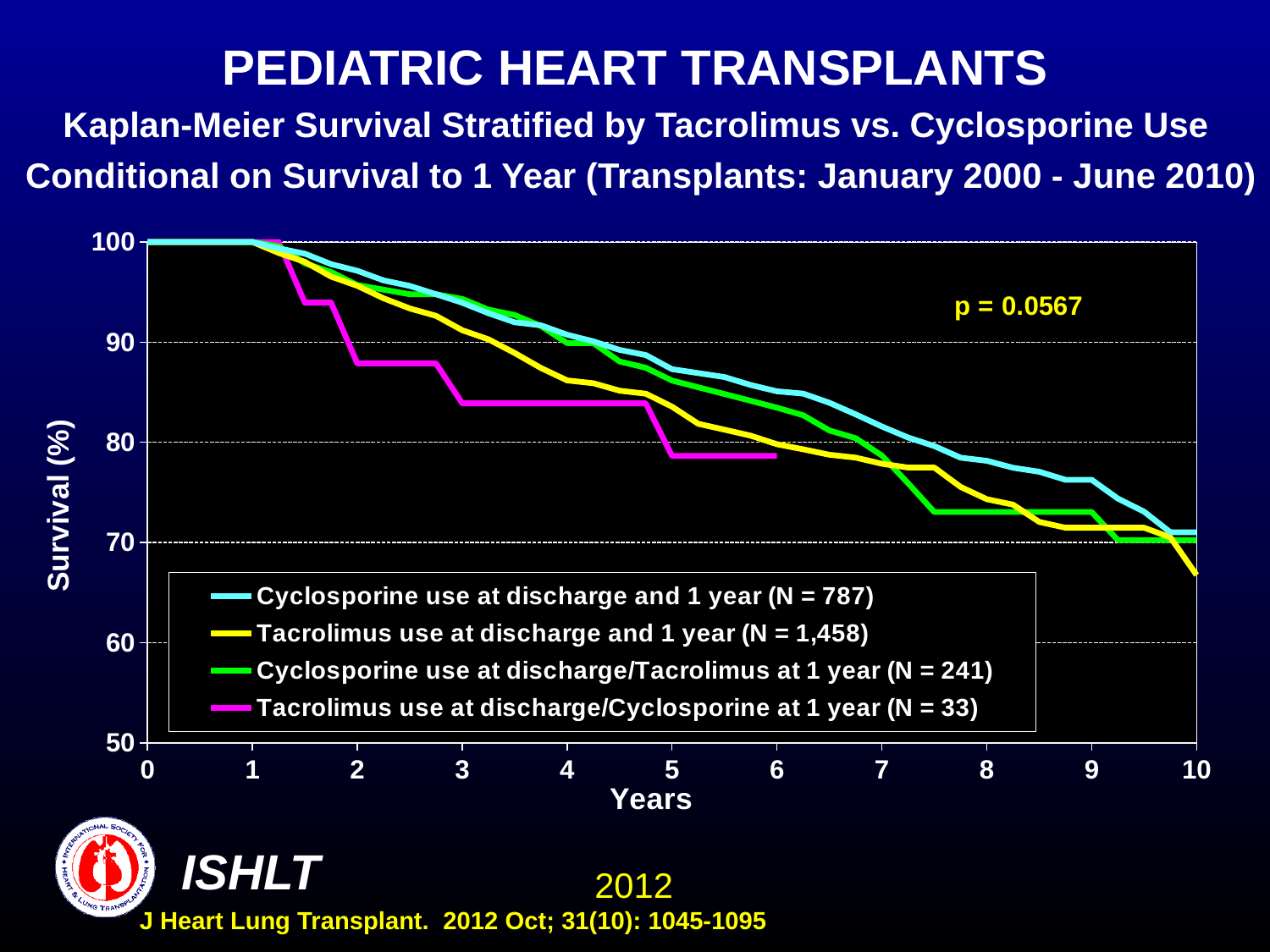
Is the survival for 'Tacrolimus use at discharge/Cyclosporine at 1 year' at year 3 greater or less than 90? less Is the survival for 'Cyclosporine use at discharge/Tacrolimus at 1 year' at year 8 greater or less than 80? less How many series does the legend list? 4 What p-value is printed on the chart? p = 0.0567 Which series has the lowest survival at year 10? Tacrolimus use at discharge and 1 year Is the survival for 'Tacrolimus use at discharge and 1 year' at year 10 greater or less than 70? less What is the N for the 'Tacrolimus use at discharge and 1 year' series in the legend? N = 1,458 What kind of chart is shown on the slide? Line chart Do the survival curves rise or fall as years increase along the x axis? Fall At year 3, which series has higher survival: 'Cyclosporine use at discharge and 1 year' or 'Tacrolimus use at discharge/Cyclosporine at 1 year'? Cyclosporine use at discharge and 1 year